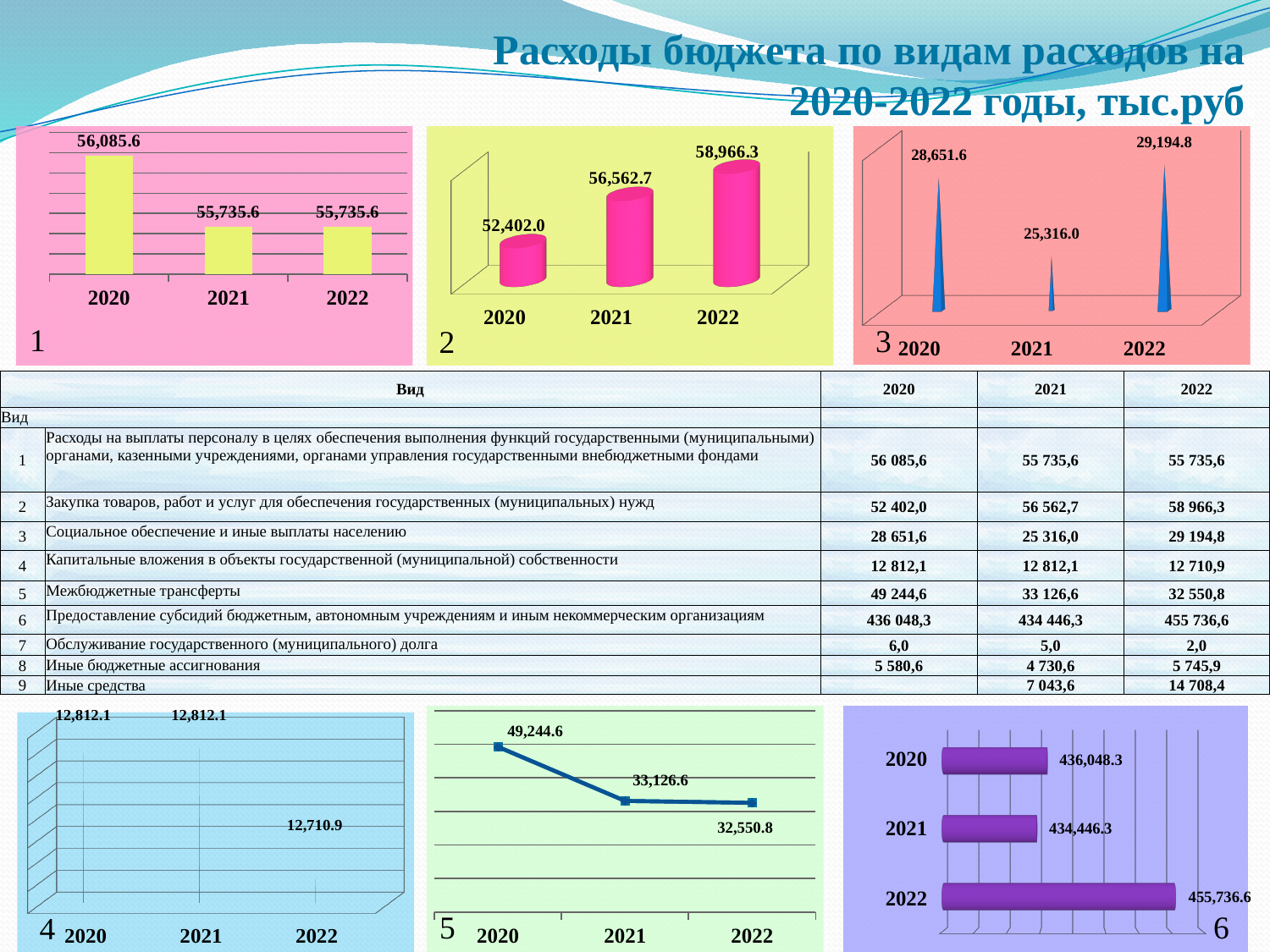
In chart 2 (top-middle, yellow background), which year has the highest value? 2022 In chart 6 (bottom-right, purple background), which is larger: the value for 2020 or the value for 2021? 2020 In chart 2 (top-middle, yellow background), what is the value for 2021? 56,562.7 What kind of chart is chart 6 (bottom-right, purple background)? bar chart How many years are plotted in chart 1 (top-left, pink background)? 3 In chart 6 (bottom-right, purple background), what is the value for 2022? 455,736.6 What kind of chart is chart 5 (bottom-middle, green background)? line chart In chart 3 (top-right, red background), which year has the lowest value? 2021 In chart 4 (bottom-left, blue background), what is the value for 2022? 12,710.9 In chart 3 (top-right, red background), what is the difference between the 2022 and 2021 values? 3,878.8 In chart 1 (top-left, pink background), what is the value for 2020? 56,085.6 In chart 5 (bottom-middle, green background), do the values rise or fall from 2020 to 2022? fall